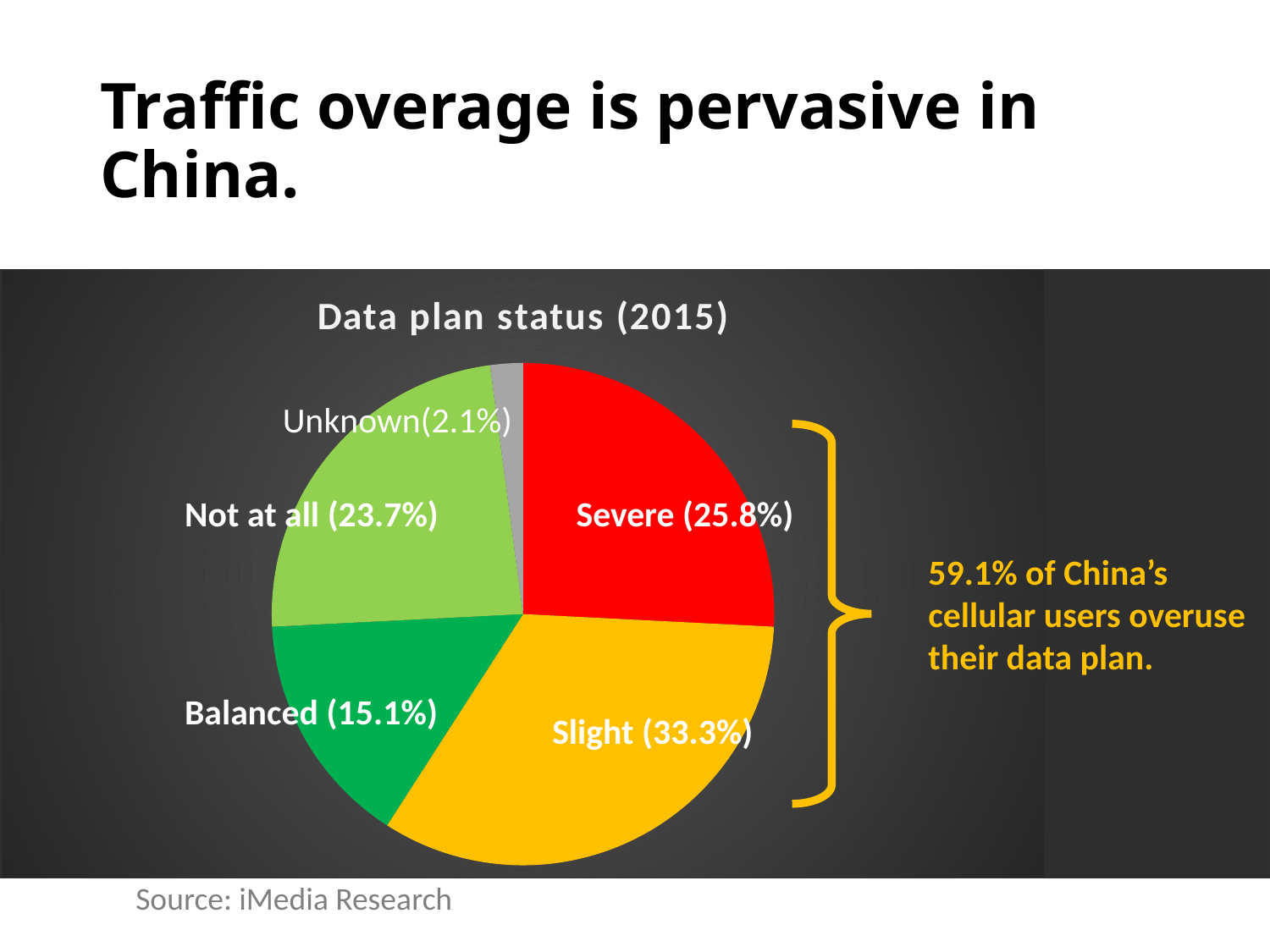
What is the difference between the Slight and Severe shares? 7.5% What share of the pie is labelled Slight? 33.3% Which is larger, the Not at all share or the Balanced share? Not at all What share of the pie is labelled Severe? 25.8% What share of the pie is labelled Unknown? 2.1% Which category has the smallest slice of the pie? Unknown What kind of chart is shown on the slide? Pie chart What is the title of the chart? Data plan status (2015) How many slices does the pie chart have? 5 Which category has the largest slice of the pie? Slight What share of the pie is labelled Balanced? 15.1% What share of the pie is labelled Not at all? 23.7%